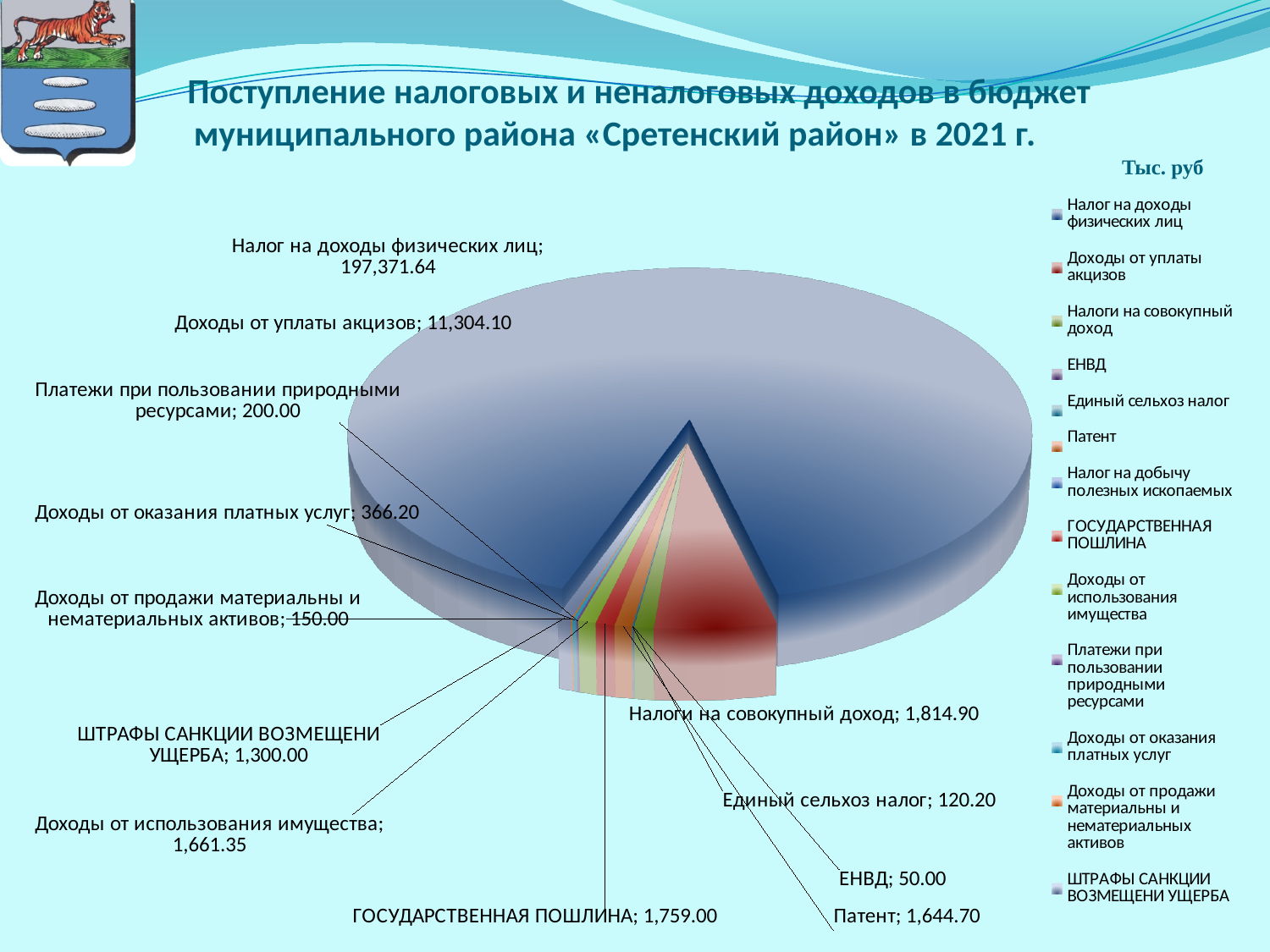
What kind of chart is shown on the slide? pie chart What is the value for Патент? 1,644.70 What is the value for Доходы от уплаты акцизов? 11,304.10 What is the value for ЕНВД? 50.00 Which is larger: ГОСУДАРСТВЕННАЯ ПОШЛИНА or Патент? ГОСУДАРСТВЕННАЯ ПОШЛИНА What is the value for Налоги на совокупный доход? 1,814.90 What is the value for ШТРАФЫ САНКЦИИ ВОЗМЕЩЕНИ УЩЕРБА? 1,300.00 What is the value for Налог на доходы физических лиц? 197,371.64 What is the difference between Налог на доходы физических лиц and Доходы от уплаты акцизов? 186,067.54 How many entries does the legend list? 13 Which category has the largest slice of the pie? Налог на доходы физических лиц In what units are the values on the chart given? Тыс. руб